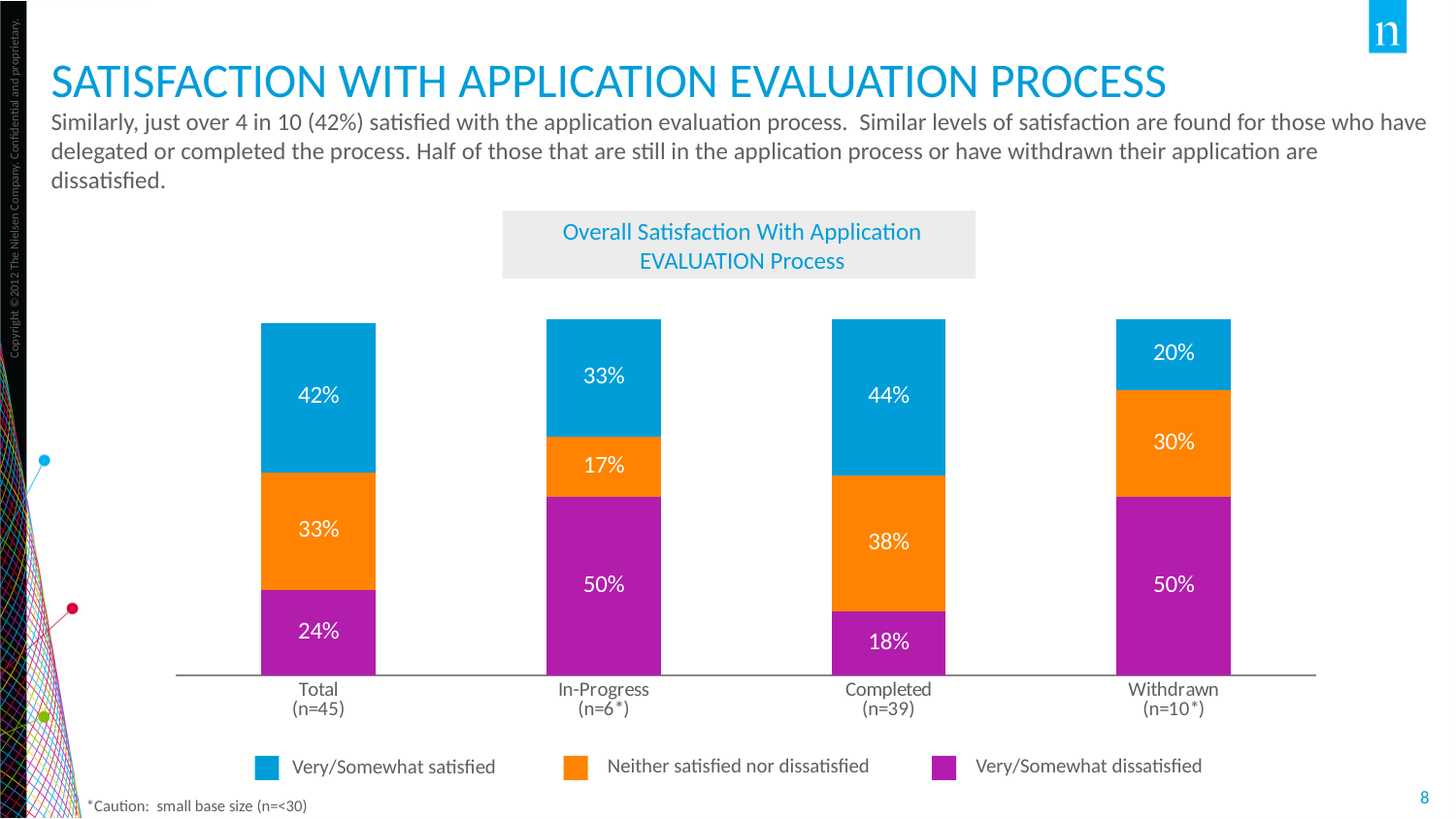
Which group has the lowest Very/Somewhat satisfied percentage? Withdrawn Which group has the highest Very/Somewhat satisfied percentage? Completed What percentage of the Total group is Very/Somewhat satisfied with the application evaluation process? 42% What percentage of the Completed group is Neither satisfied nor dissatisfied? 38% How many groups are shown on the x axis of the chart? 4 What kind of chart is shown on the slide? Stacked bar chart What is the difference between the Very/Somewhat dissatisfied percentages for In-Progress and Completed? 32 percentage points What is the total of the three segments in the In-Progress bar? 100% Which is larger: the Neither satisfied nor dissatisfied share for Total or for Withdrawn? Total What is the sample size shown for the Completed group? n=39 How many series does the legend list? 3 What percentage of the Withdrawn group is Very/Somewhat dissatisfied? 50%